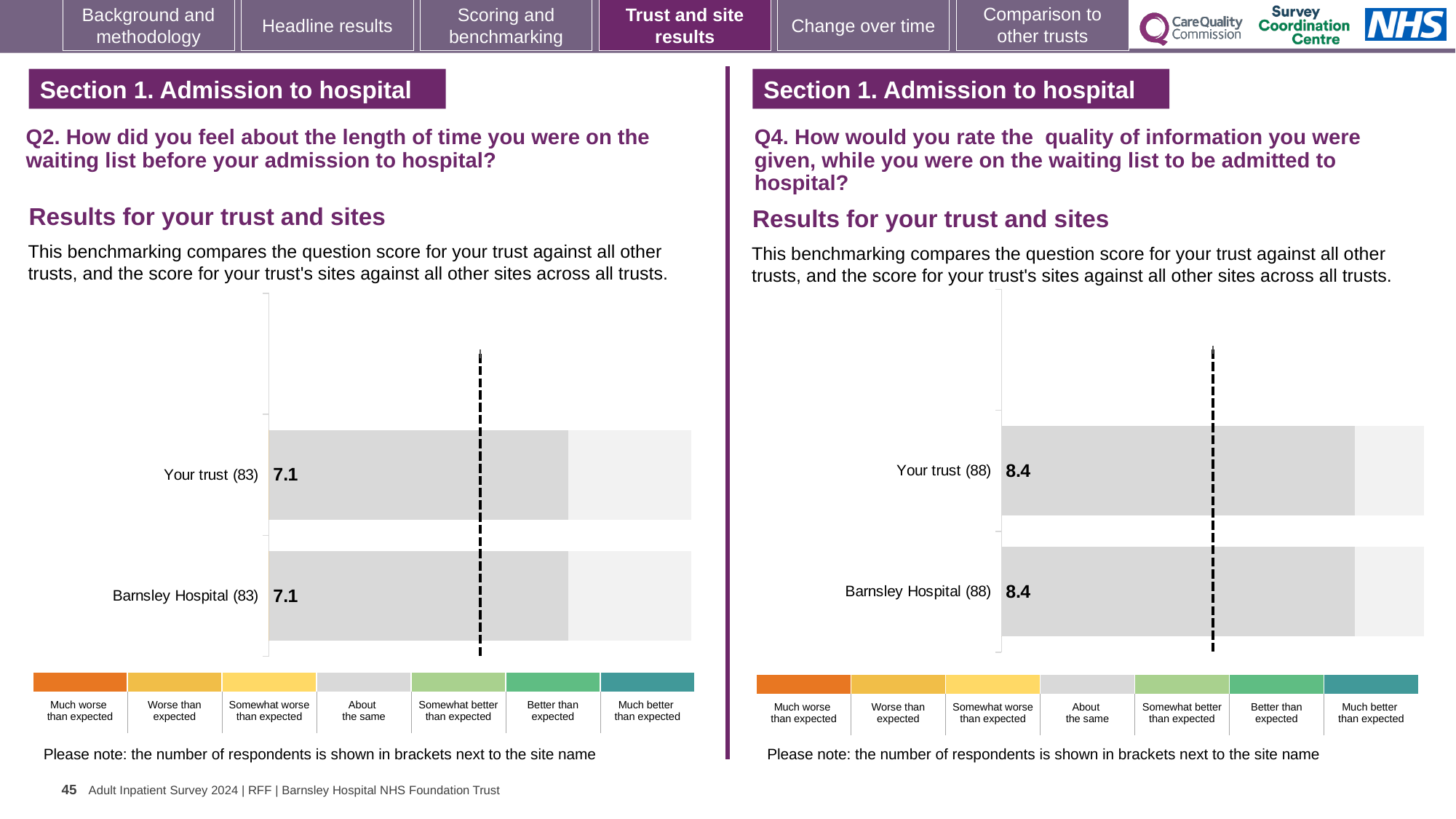
On the left chart (Q2), how many respondents are shown in brackets next to Your trust? 83 On the left chart (Q2), what is the score for Your trust? 7.1 How many bars are plotted on the left chart (Q2)? 2 Is the score for Your trust on the right chart (Q4) larger or smaller than the score for Your trust on the left chart (Q2)? Larger On the left chart (Q2), what is the difference between the score for Your trust and the score for Barnsley Hospital? 0 On the left chart (Q2), what is the score for Barnsley Hospital? 7.1 On the right chart (Q4), how many respondents are shown in brackets next to Barnsley Hospital? 88 On the right chart (Q4), what is the score for Barnsley Hospital? 8.4 On the right chart (Q4), what is the score for Your trust? 8.4 On the right chart (Q4), what is the difference between the score for Your trust and the score for Barnsley Hospital? 0 What kind of chart is the left chart (Q2)? Bar chart How many bars are plotted on the right chart (Q4)? 2